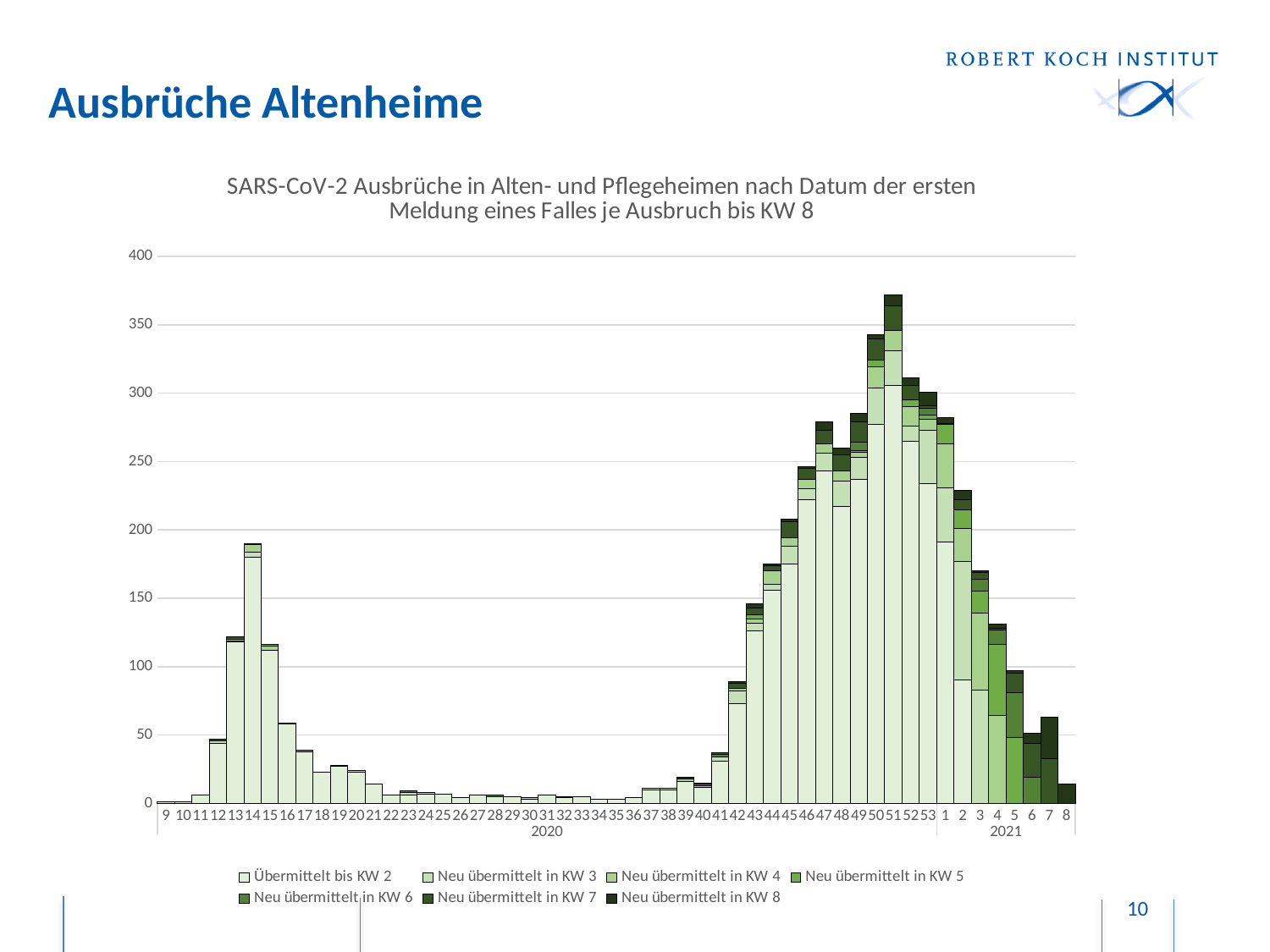
Which has the larger total bar, KW 13 2020 or KW 14 2020? KW 14 2020 Is the total value for KW 47 2020 greater or less than 250? greater What is the first legend entry of the chart? Übermittelt bis KW 2 Is the total value for KW 8 2021 greater or less than 50? less How many series does the legend list? 7 Which calendar week has the highest total bar? KW 51 2020 Is the total value for KW 30 2020 greater or less than 50? less Do the total values rise or fall from KW 51 2020 to KW 8 2021? fall What kind of chart is shown on the slide? stacked bar chart How many calendar weeks (categories) are plotted along the x axis? 53